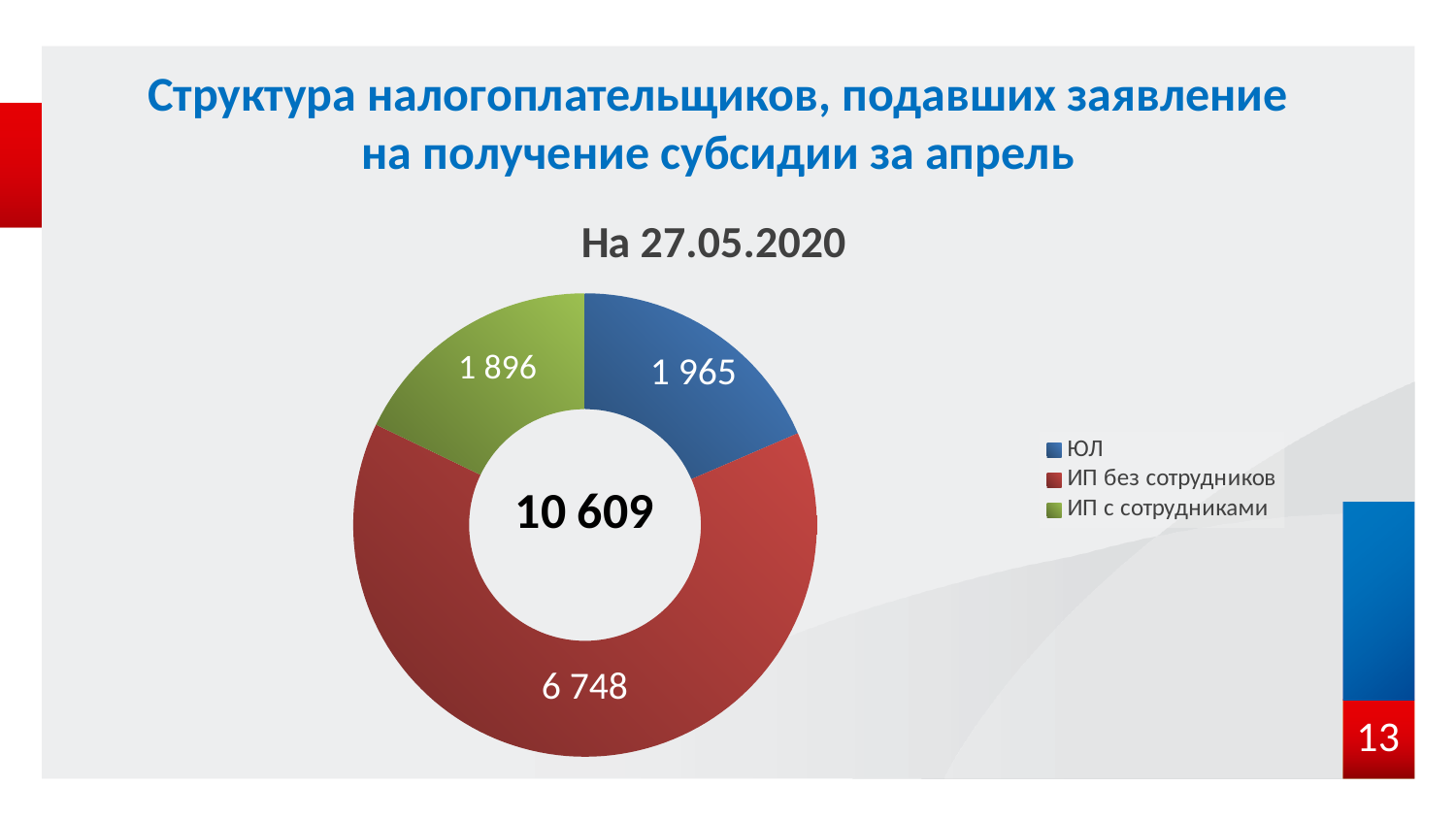
What date is given in the chart title? 27.05.2020 Which category has the smallest value? ИП с сотрудниками What is the value for ИП без сотрудников? 6 748 Which category has the largest value? ИП без сотрудников What type of chart is shown on the slide? Doughnut (pie) chart What total is shown in the centre of the chart? 10 609 How many categories does the chart show? 3 What is the value for ИП с сотрудниками? 1 896 What is the difference between ЮЛ and ИП с сотрудниками? 69 Which is larger, ЮЛ or ИП с сотрудниками? ЮЛ What is the value for ЮЛ? 1 965 What is the difference between ИП без сотрудников and ЮЛ? 4 783